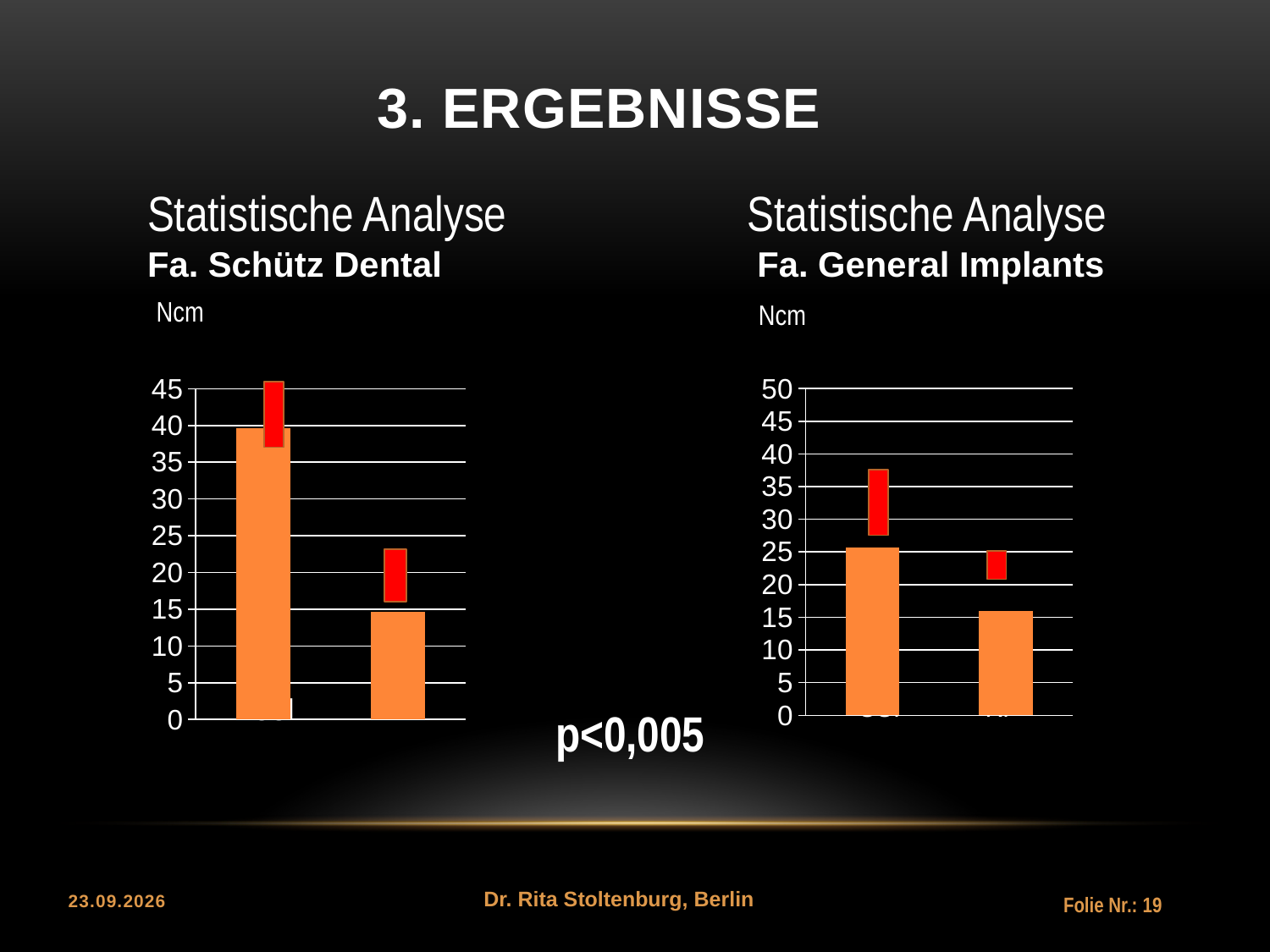
How many bars are plotted in the Fa. General Implants chart? 2 In the Fa. Schütz Dental chart, is the value of the left bar greater or less than 35? greater In the Fa. General Implants chart, is the value of the left bar greater or less than 20? greater In the Fa. Schütz Dental chart, which bar is taller, the left bar or the right bar? the left bar In the Fa. General Implants chart, is the value of the right bar greater or less than 20? less What is the highest value shown on the y axis of the Fa. General Implants chart? 50 How many bar charts are shown on the slide? 2 What kind of chart is the Fa. Schütz Dental chart? bar chart In the Fa. General Implants chart, which bar is the lowest? the right bar What unit is shown above the y axis of both charts? Ncm